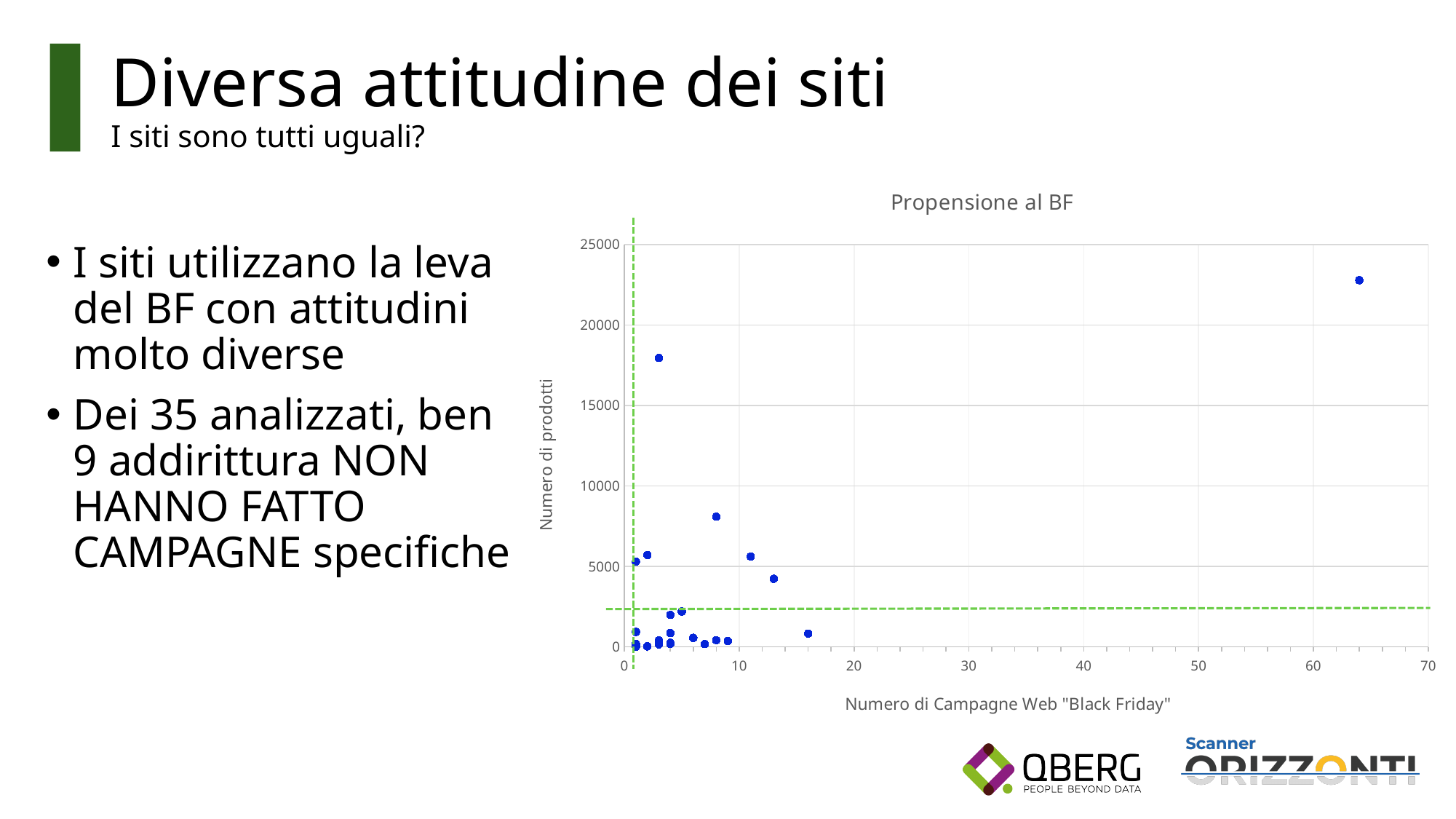
What is the highest value shown on the x axis of the chart? 70 Is the number of products for the second-highest point on the chart greater or less than 15000? greater Excluding the two highest points, are the remaining points above or below 10000 products? below What kind of chart is shown on the slide? Scatter chart Is the number of Black Friday campaigns for the rightmost point greater or less than 60? greater What is the label of the x axis of the chart? Numero di Campagne Web "Black Friday" Which point has the higher number of products: the rightmost point or the point near 3 campaigns with about 18000 products? The rightmost point What is the title of the chart? Propensione al BF What is the highest value shown on the y axis of the chart? 25000